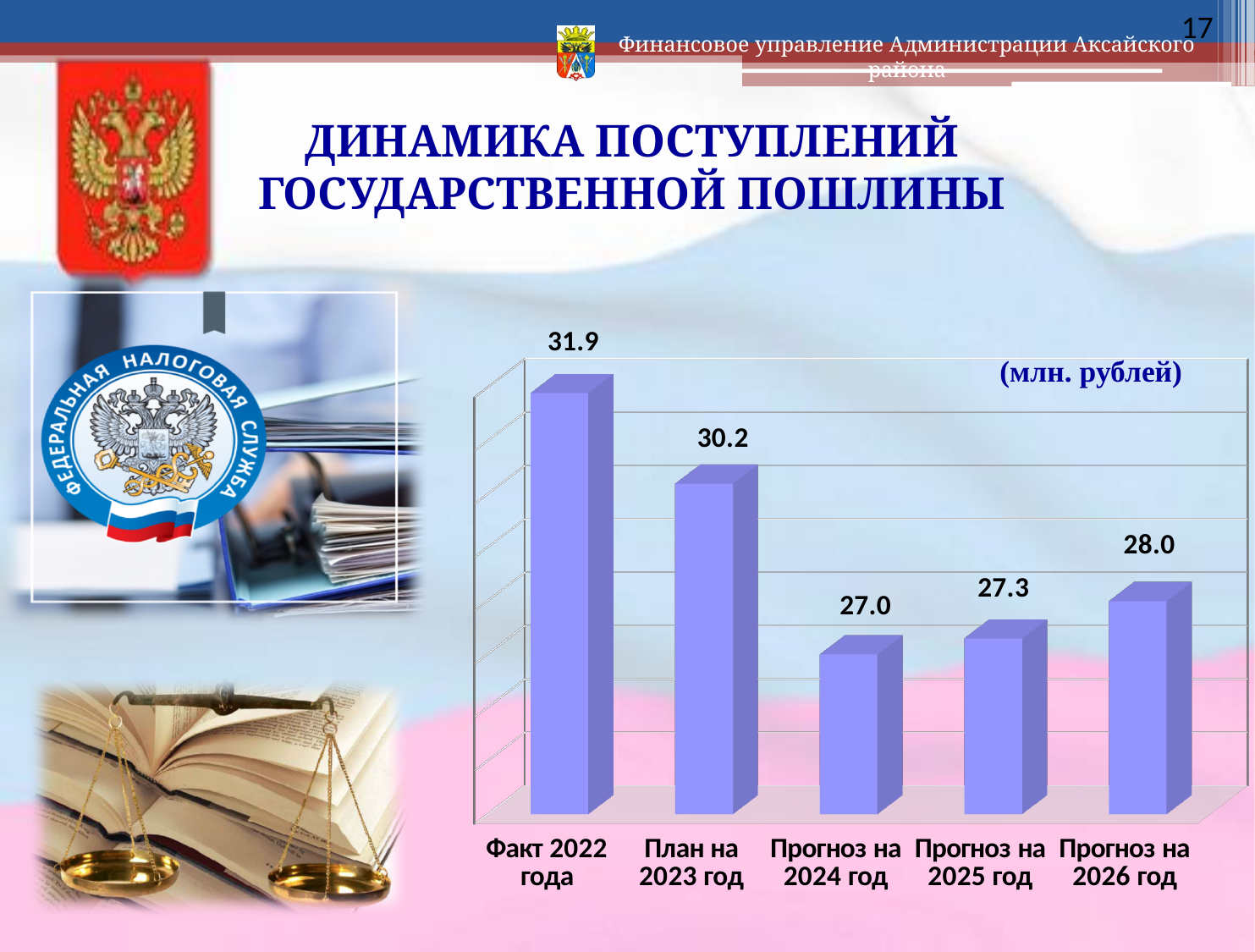
Which category has the lowest value? Прогноз на 2024 год Do the values rise or fall from Факт 2022 года to Прогноз на 2024 год? fall What is the value for План на 2023 год? 30.2 What is the difference between the values for Факт 2022 года and План на 2023 год? 1.7 What is the value for Прогноз на 2026 год? 28.0 What is the value for Факт 2022 года? 31.9 How many categories are shown in the chart? 5 What kind of chart is shown on the slide? bar chart Which is larger, the value for Прогноз на 2025 год or Прогноз на 2026 год? Прогноз на 2026 год Which category has the highest value? Факт 2022 года What is the difference between the values for Прогноз на 2026 год and Прогноз на 2024 год? 1.0 What unit is indicated for the chart values? млн. рублей